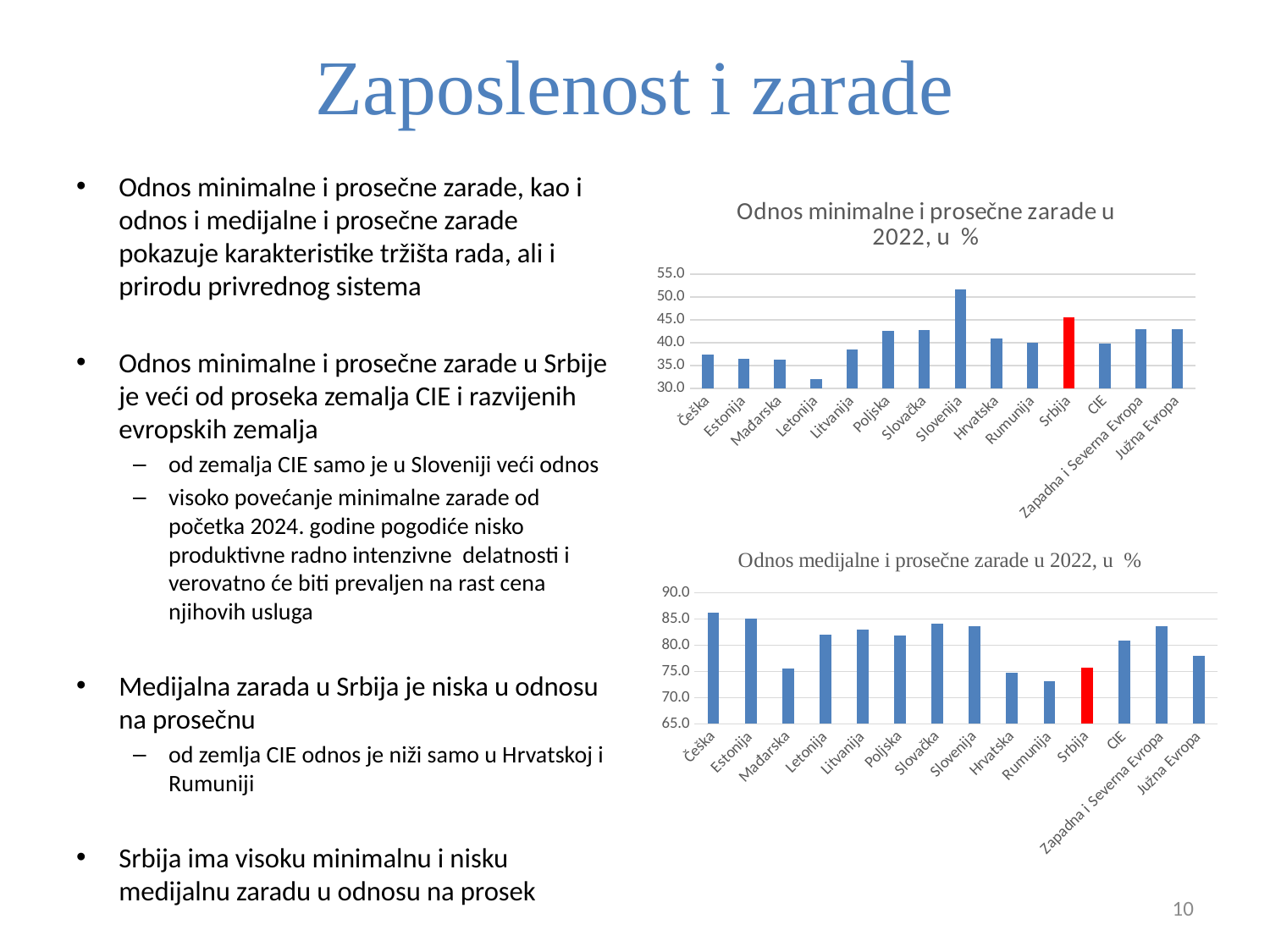
How many categories are shown in the top chart 'Odnos minimalne i prosečne zarade u 2022, u %'? 14 In the top chart 'Odnos minimalne i prosečne zarade u 2022, u %', is the value for Letonija greater or less than 35.0? less In the top chart 'Odnos minimalne i prosečne zarade u 2022, u %', which category has the highest value? Slovenija In the top chart 'Odnos minimalne i prosečne zarade u 2022, u %', which category has the lowest value? Letonija In the top chart 'Odnos minimalne i prosečne zarade u 2022, u %', is the value for Slovenija greater or less than 50.0? greater In the bottom chart 'Odnos medijalne i prosečne zarade u 2022, u %', which category has the highest value? Češka What kind of chart is the top chart, 'Odnos minimalne i prosečne zarade u 2022, u %'? bar chart In the top chart 'Odnos minimalne i prosečne zarade u 2022, u %', is the value for Srbija greater or less than 40.0? greater In the bottom chart 'Odnos medijalne i prosečne zarade u 2022, u %', which bar is coloured red? Srbija In the bottom chart 'Odnos medijalne i prosečne zarade u 2022, u %', which category has the lowest value? Rumunija In the top chart 'Odnos minimalne i prosečne zarade u 2022, u %', which is larger, the value for Srbija or the value for CIE? Srbija